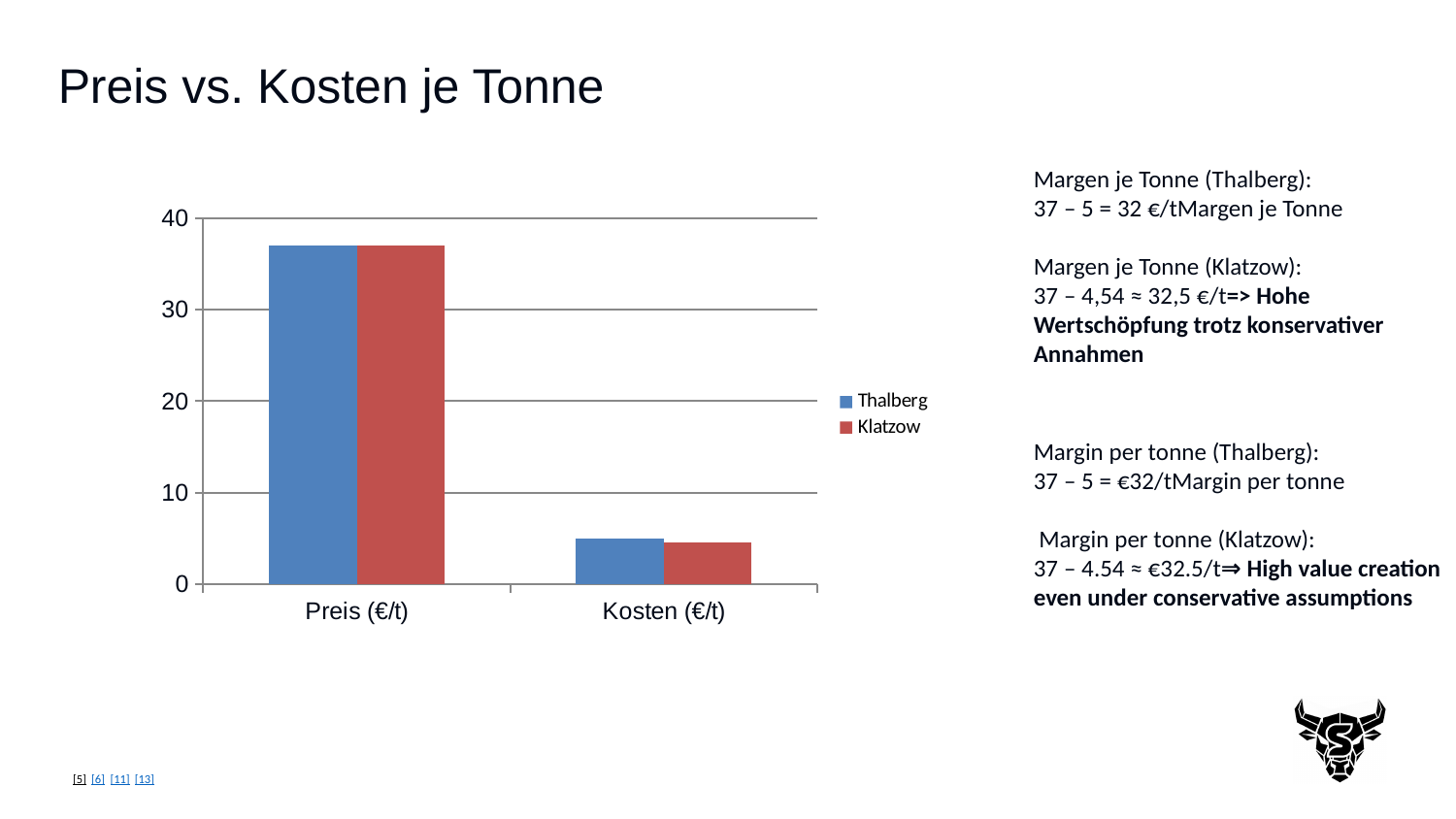
How many categories are shown on the x axis of the chart? 2 How many series does the chart legend list? 2 Is the Thalberg value for Preis (€/t) greater or less than 30? greater What is the title of the chart? Preis vs. Kosten je Tonne For Klatzow, which category has the lowest value? Kosten (€/t) What kind of chart is shown on the slide? bar chart For Thalberg, which is larger: Preis (€/t) or Kosten (€/t)? Preis (€/t) Is the Thalberg value for Preis (€/t) greater or less than 40? less Is the Thalberg value for Kosten (€/t) greater or less than 10? less Which series is shown in blue in the chart? Thalberg